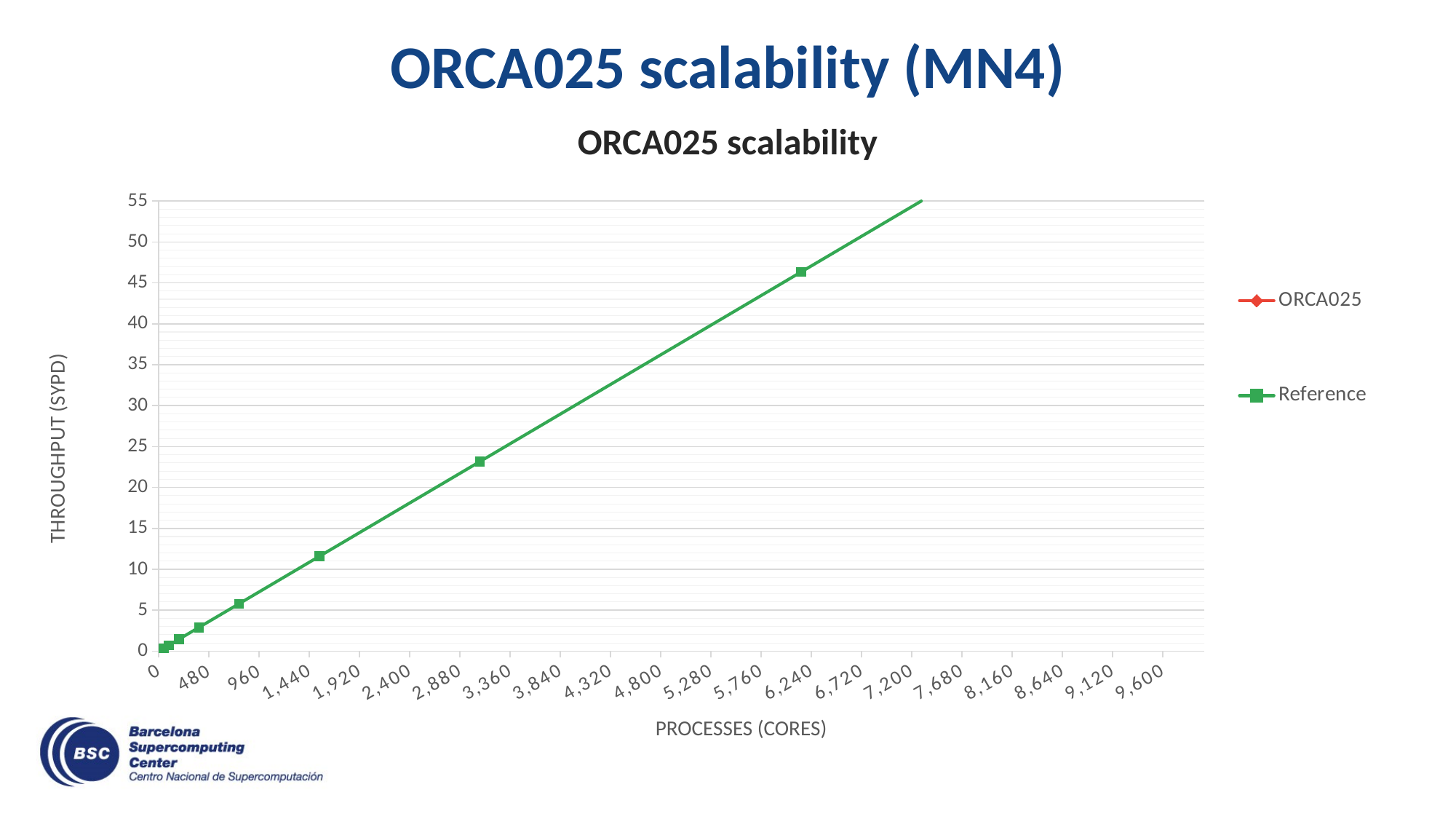
What is the title of the chart? ORCA025 scalability Is the value of the Reference marker near 1,920 cores greater or less than 10? greater How many series does the legend list? 2 Is the value of the Reference marker near 3,360 cores greater or less than 30? less Is the value of the Reference marker near 960 cores greater or less than 10? less Which series is drawn with green square markers? Reference What kind of chart is shown on the slide? line chart What is the label of the y axis? THROUGHPUT (SYPD) Does the Reference series rise or fall as the number of processes increases? rise